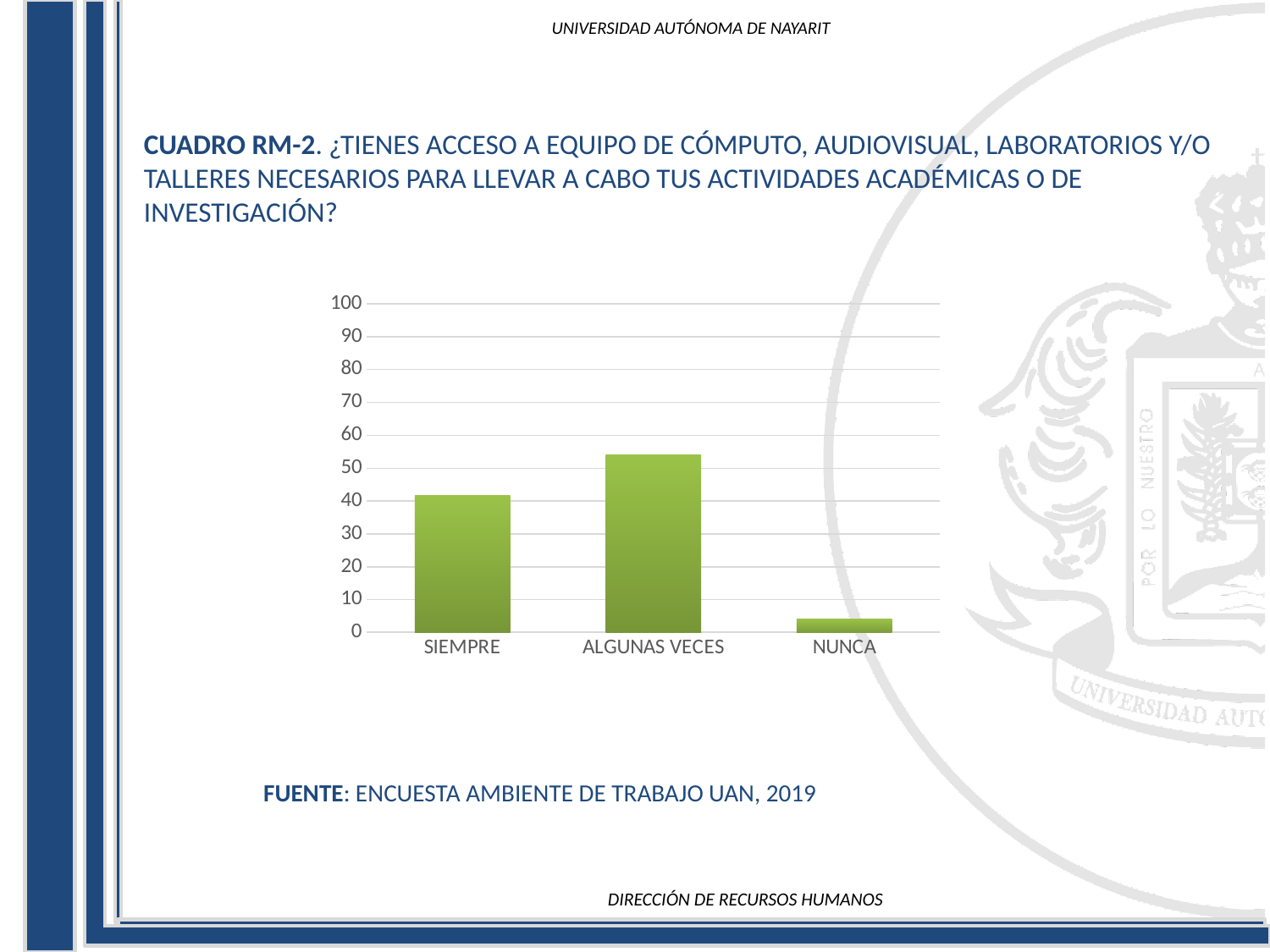
What source is cited below the chart? ENCUESTA AMBIENTE DE TRABAJO UAN, 2019 Which category has the highest bar? ALGUNAS VECES How many categories are shown on the x axis? 3 What is the highest value shown on the vertical axis? 100 What kind of chart is shown on the slide? bar chart Is the value for ALGUNAS VECES greater or less than 50? greater Is the value for SIEMPRE greater or less than 50? less Which category has the lowest bar? NUNCA Which is larger, the value for SIEMPRE or the value for NUNCA? SIEMPRE Is the value for SIEMPRE greater or less than 30? greater Which is larger, the value for SIEMPRE or the value for ALGUNAS VECES? ALGUNAS VECES